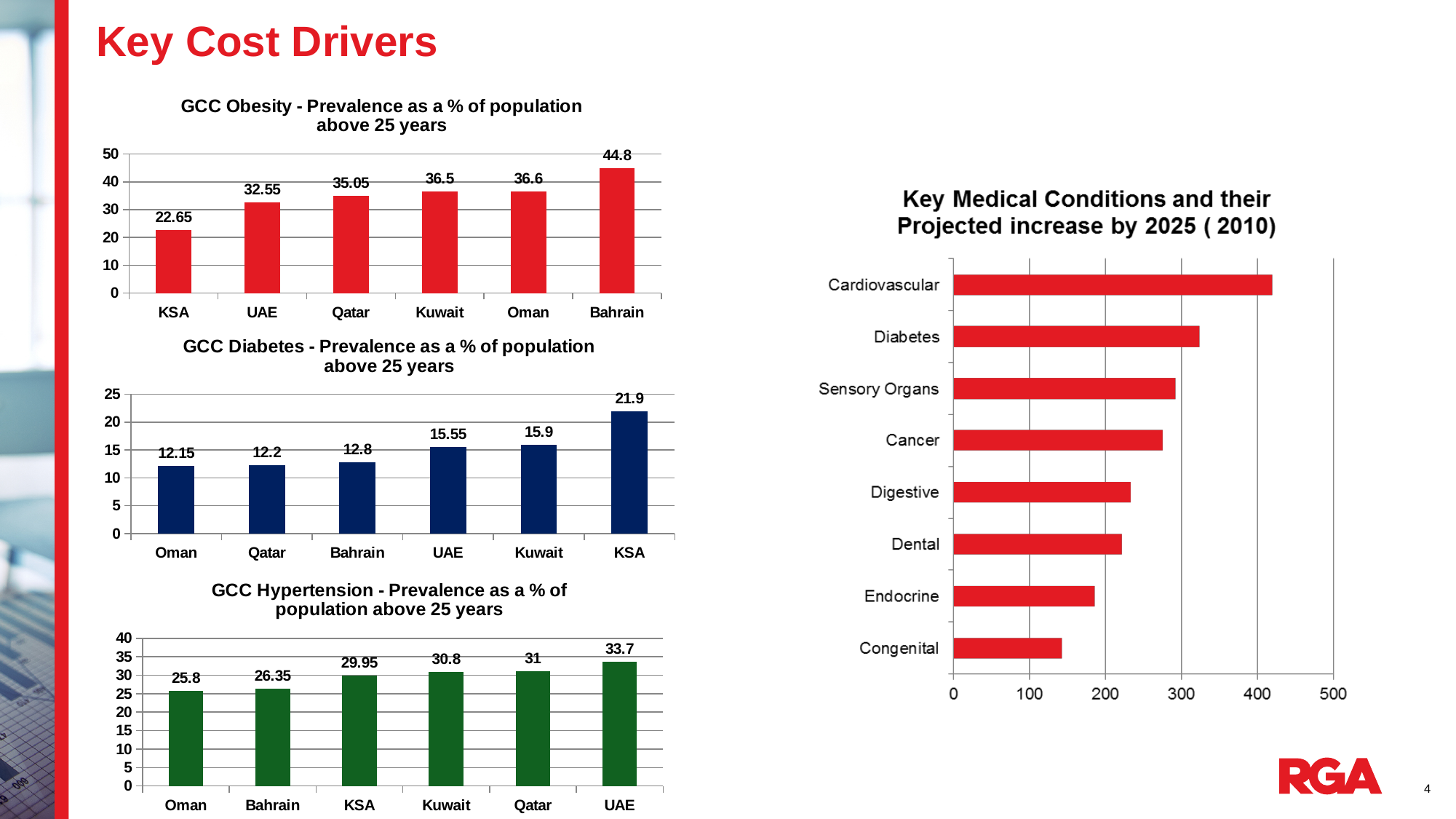
In the Key Medical Conditions chart, which condition has the lowest projected increase? Congenital In the GCC Diabetes chart, how many countries are shown? 6 In the GCC Obesity chart, do the values rise or fall from left to right? rise What kind of chart is the Key Medical Conditions chart? bar chart In the GCC Hypertension chart, which country has the highest prevalence? UAE In the GCC Hypertension chart, which is larger, the value for Oman or the value for KSA? KSA In the GCC Diabetes chart, what is the value for KSA? 21.9 In the GCC Diabetes chart, what is the difference between KSA and Oman? 9.75 In the GCC Obesity chart, what is the value for Bahrain? 44.8 In the Key Medical Conditions chart, is the value for Cardiovascular greater or less than 400? greater In the GCC Obesity chart, which country has the lowest prevalence? KSA In the GCC Hypertension chart, what is the value for Kuwait? 30.8